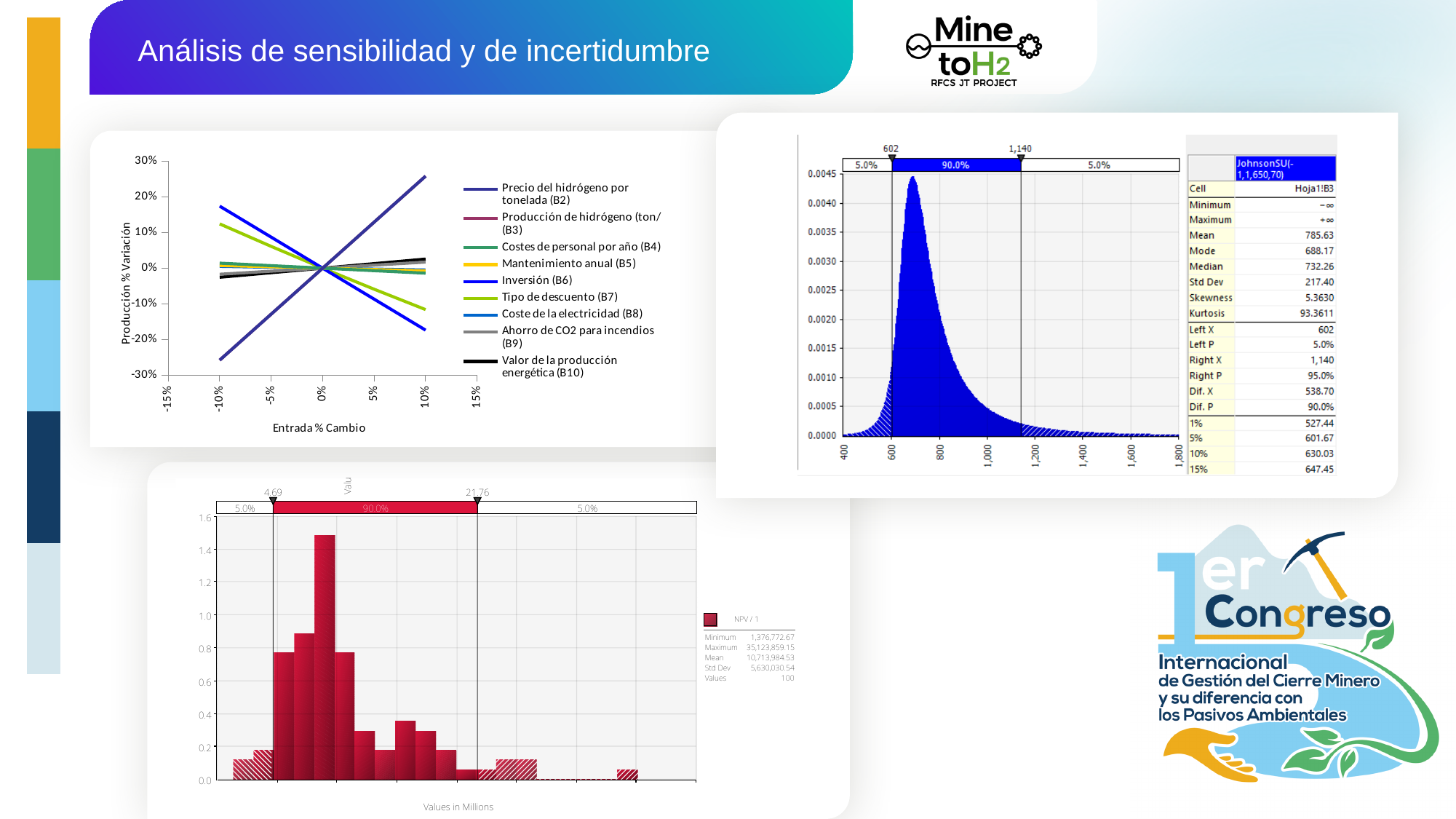
How many series does the legend of the top-left line chart list? 9 In the top-left line chart, does the line for Inversión (B6) rise or fall as the input change goes from -10% to 10%? fall In the top-right blue distribution chart, what are the left and right x values bounding the 90.0% band? 602 and 1,140 In the top-right blue distribution chart, what is the Std Dev shown in the statistics table? 217.40 In the bottom-left red histogram, what is the Mean shown in the legend statistics? 10,713,984.53 In the top-left line chart, is the value for Inversión (B6) at 10% input change greater or less than -10%? less What kind of chart is the top-left chart with the x axis 'Entrada % Cambio'? line chart In the top-right blue distribution chart, what is the Mean shown in the statistics table? 785.63 In the top-right blue distribution chart, what is the Median shown in the statistics table? 732.26 In the bottom-left red histogram, how many values does the legend report? 100 In the top-left line chart, which series has the steepest rising line? Precio del hidrógeno por tonelada (B2) In the top-left line chart, is the value for Precio del hidrógeno por tonelada (B2) at 10% input change greater or less than 20%? greater